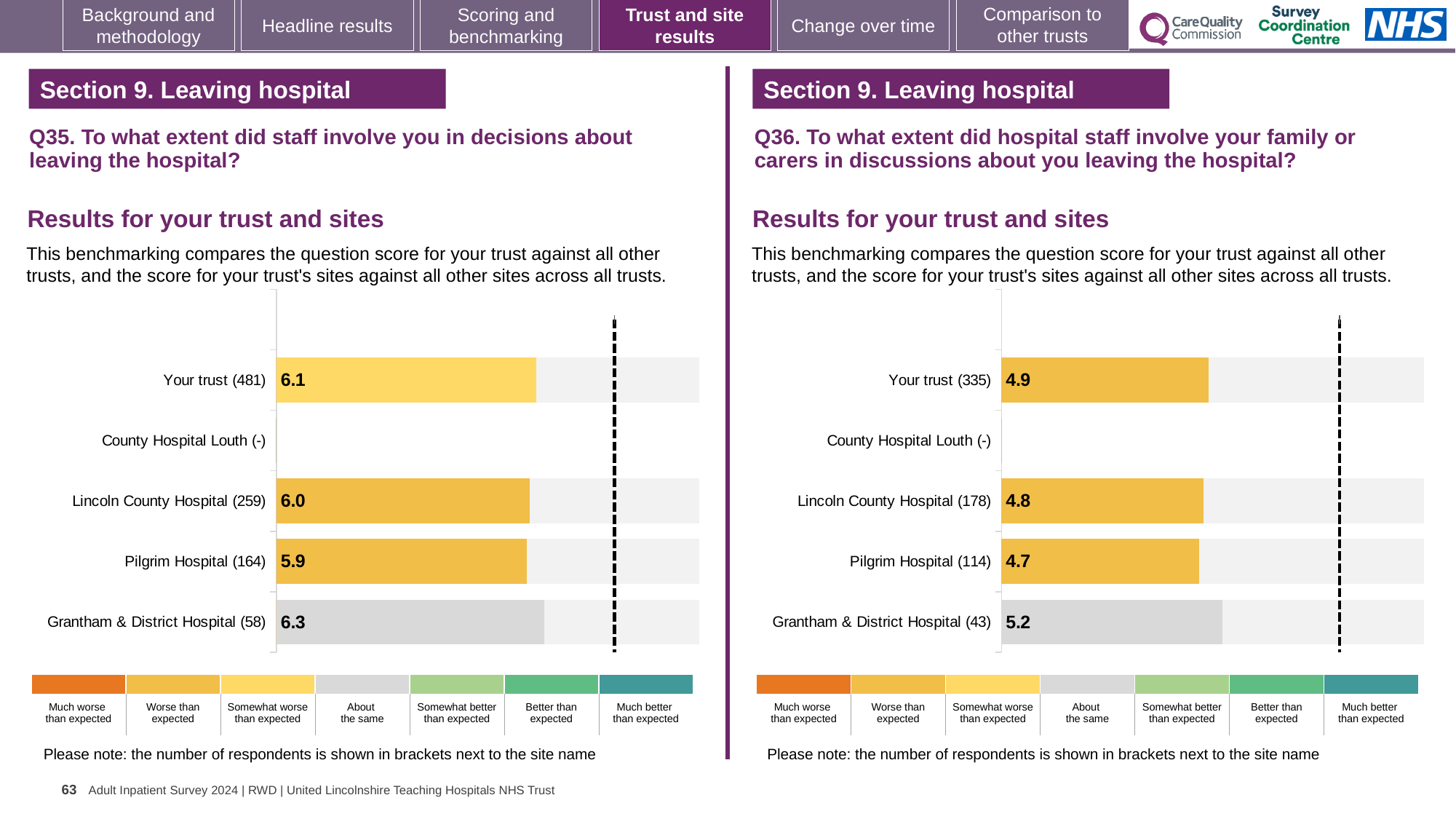
In the Q35 chart on the left, which has the higher score: Your trust or Lincoln County Hospital? Your trust In the Q35 chart on the left, which site has the highest score? Grantham & District Hospital (58) What type of chart is used in the Q35 chart on the left? Bar chart In the Q36 chart on the right, what is the difference between the scores for Grantham & District Hospital and Your trust? 0.3 In the Q36 chart on the right, how many bars have a score plotted? 4 In the Q36 chart on the right, what is the score for Your trust (335)? 4.9 In the Q36 chart on the right, what is the score for Lincoln County Hospital (178)? 4.8 In the Q36 chart on the right, which site has the lowest score? Pilgrim Hospital (114) How many benchmark categories does the colour key below the Q35 chart on the left list? 7 In the Q35 chart on the left, what is the score for Your trust (481)? 6.1 In the Q35 chart on the left, what is the score for Pilgrim Hospital (164)? 5.9 In the Q35 chart on the left, what is the difference between the scores for Grantham & District Hospital and Pilgrim Hospital? 0.4